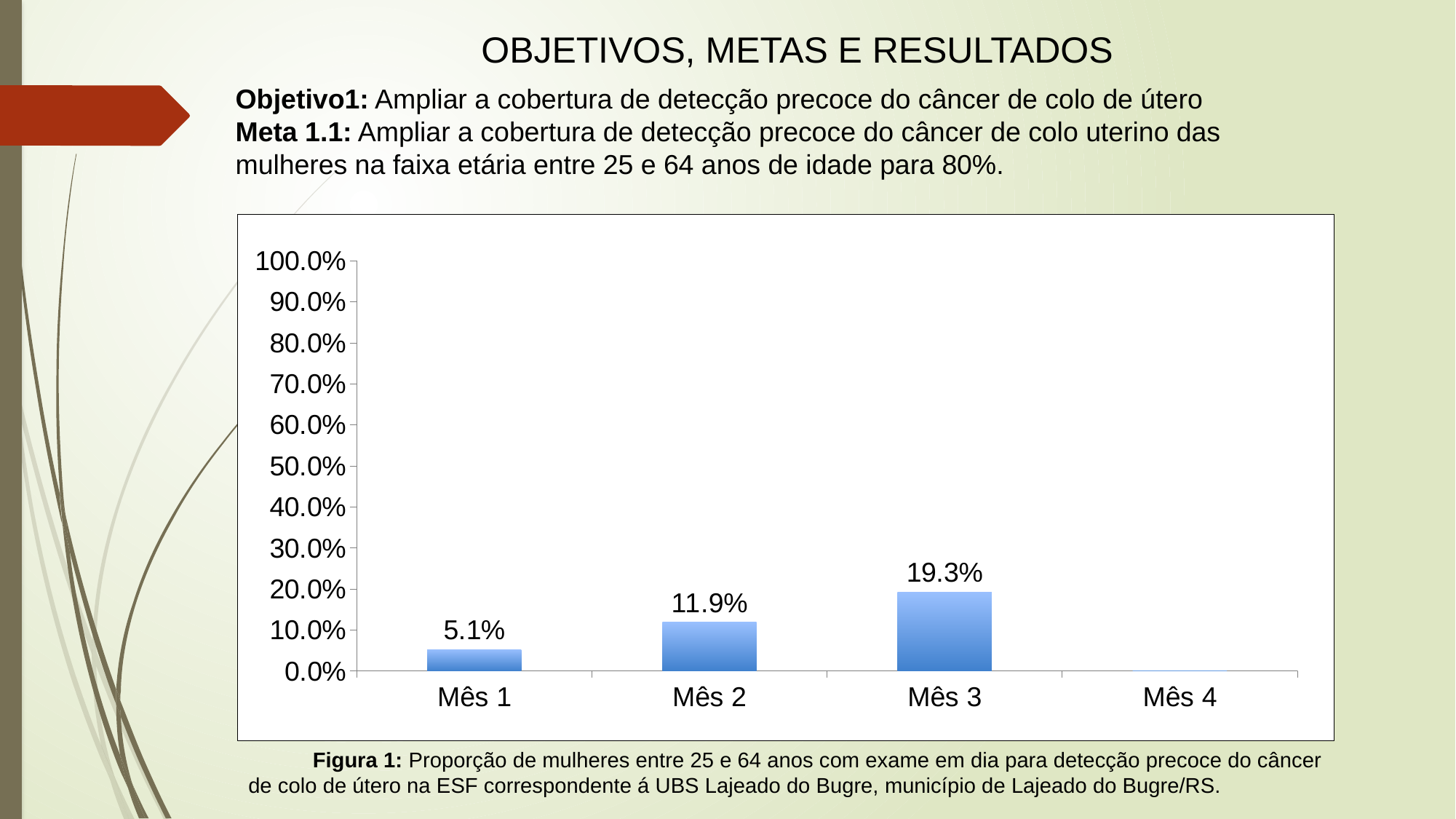
What is the difference between the values for Mês 3 and Mês 1? 14.2% Among the months with a plotted bar, which has the lowest value? Mês 1 What is the value for Mês 3? 19.3% What is the value for Mês 1? 5.1% Which month has the highest value? Mês 3 What kind of chart is shown on the slide? bar chart What is the value for Mês 2? 11.9% How many month categories are shown on the x axis? 4 Do the values rise or fall from Mês 1 to Mês 3? rise What is the difference between the values for Mês 2 and Mês 1? 6.8% Which is larger, the value for Mês 2 or the value for Mês 3? Mês 3 Is the value for Mês 3 greater or less than 20.0%? less